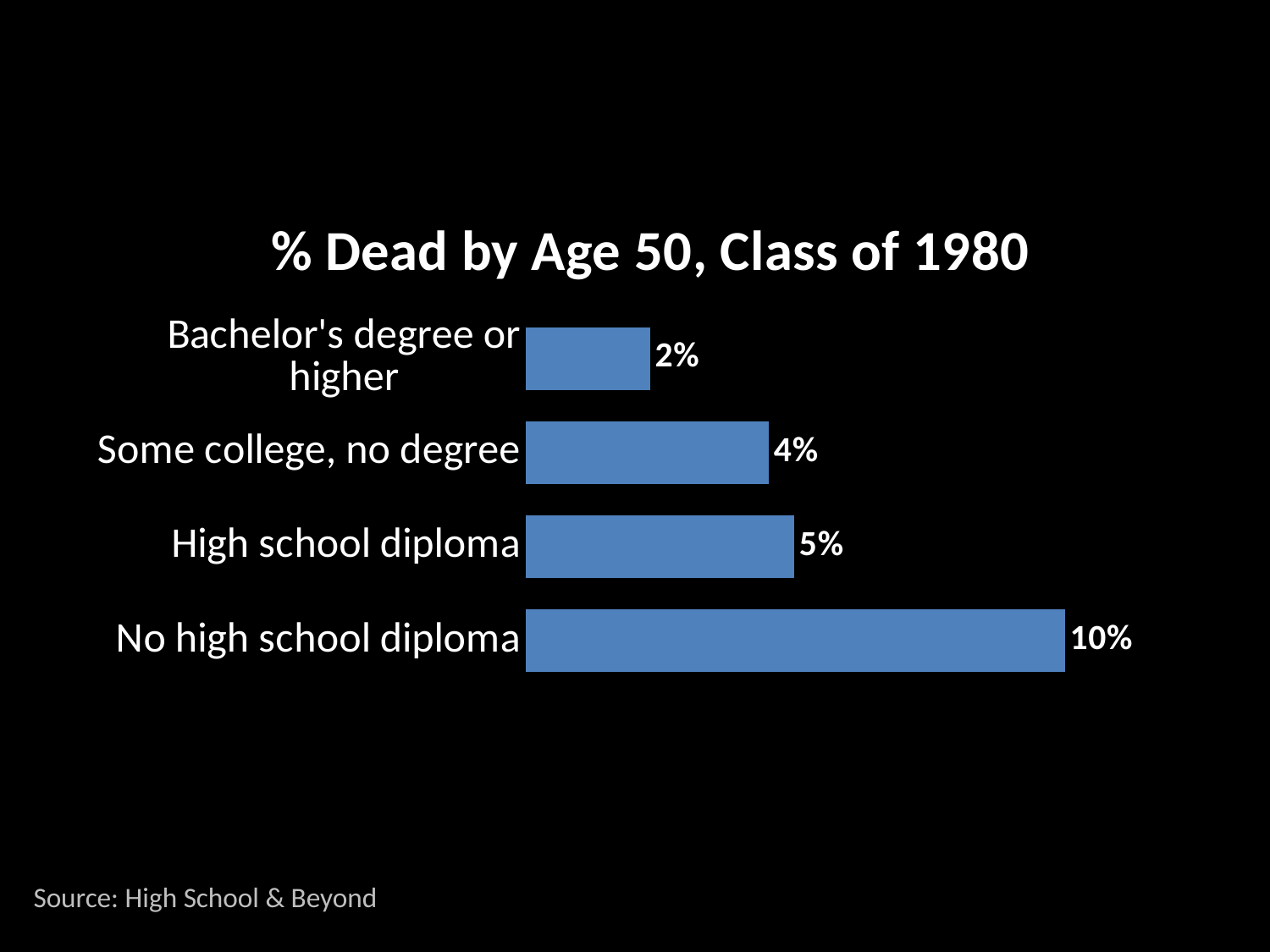
What is the difference between the values for No high school diploma and High school diploma? 5% How many categories are shown in the chart? 4 Which category has the lowest value? Bachelor's degree or higher What is the value for High school diploma? 5% What is the value for Some college, no degree? 4% What is the title of the chart? % Dead by Age 50, Class of 1980 Which category has the highest value? No high school diploma What is the difference between the values for Some college, no degree and Bachelor's degree or higher? 2% Which is larger, the value for High school diploma or the value for Some college, no degree? High school diploma What is the value for No high school diploma? 10% What is the value for Bachelor's degree or higher? 2% What kind of chart is shown on the slide? Bar chart